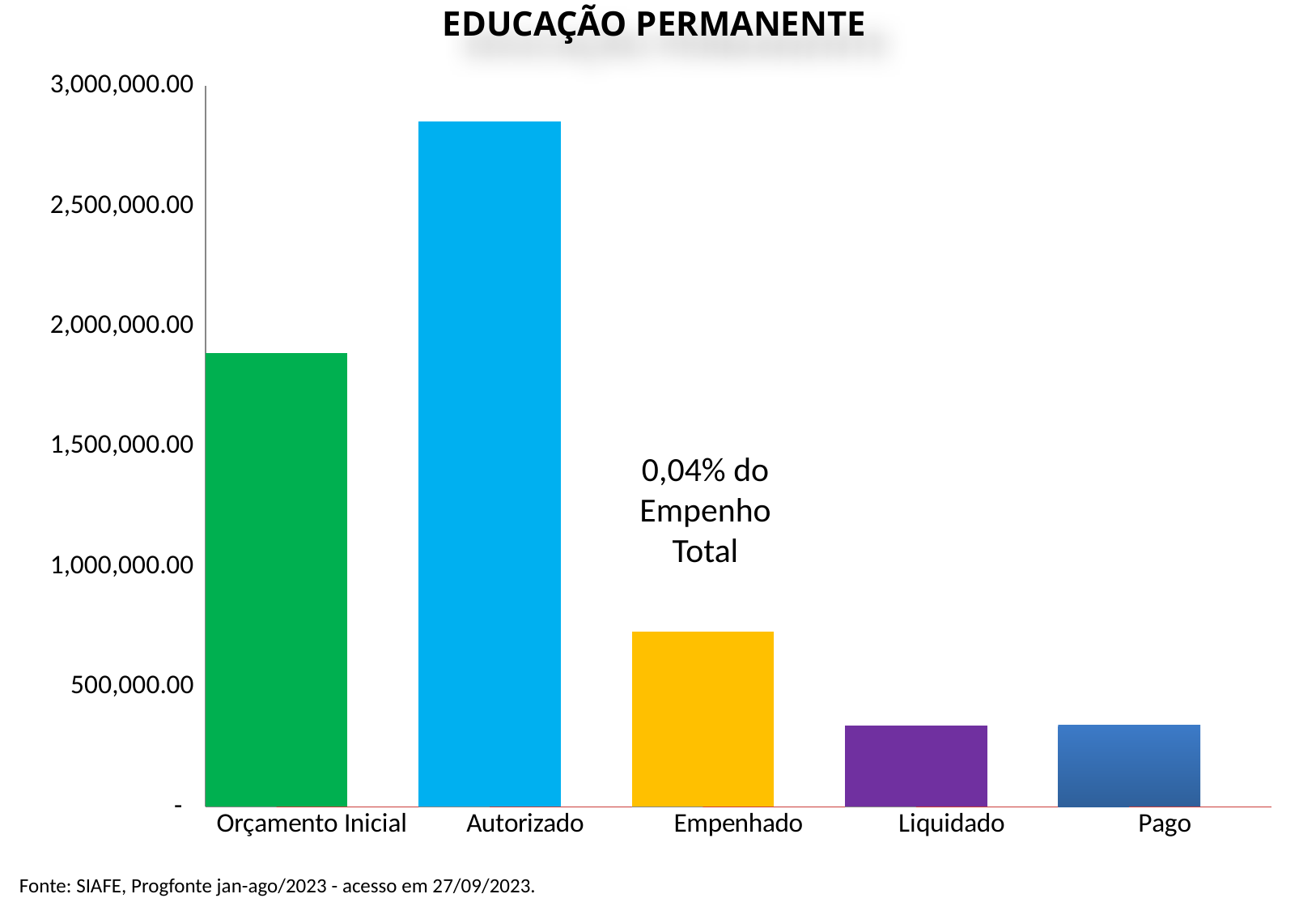
Is the value for Liquidado greater or less than 500,000.00? less Which is larger, the value for Autorizado or the value for Orçamento Inicial? Autorizado Is the value for Empenhado greater or less than 500,000.00? greater How many categories are plotted on the x axis? 5 Which category has the highest value? Autorizado Is the value for Orçamento Inicial greater or less than 2,000,000.00? less What kind of chart is shown on the slide? bar chart What percentage of the total Empenho does the annotation above the Empenhado bar state? 0,04% What is the title of the chart? EDUCAÇÃO PERMANENTE Which is larger, the value for Orçamento Inicial or the value for Empenhado? Orçamento Inicial